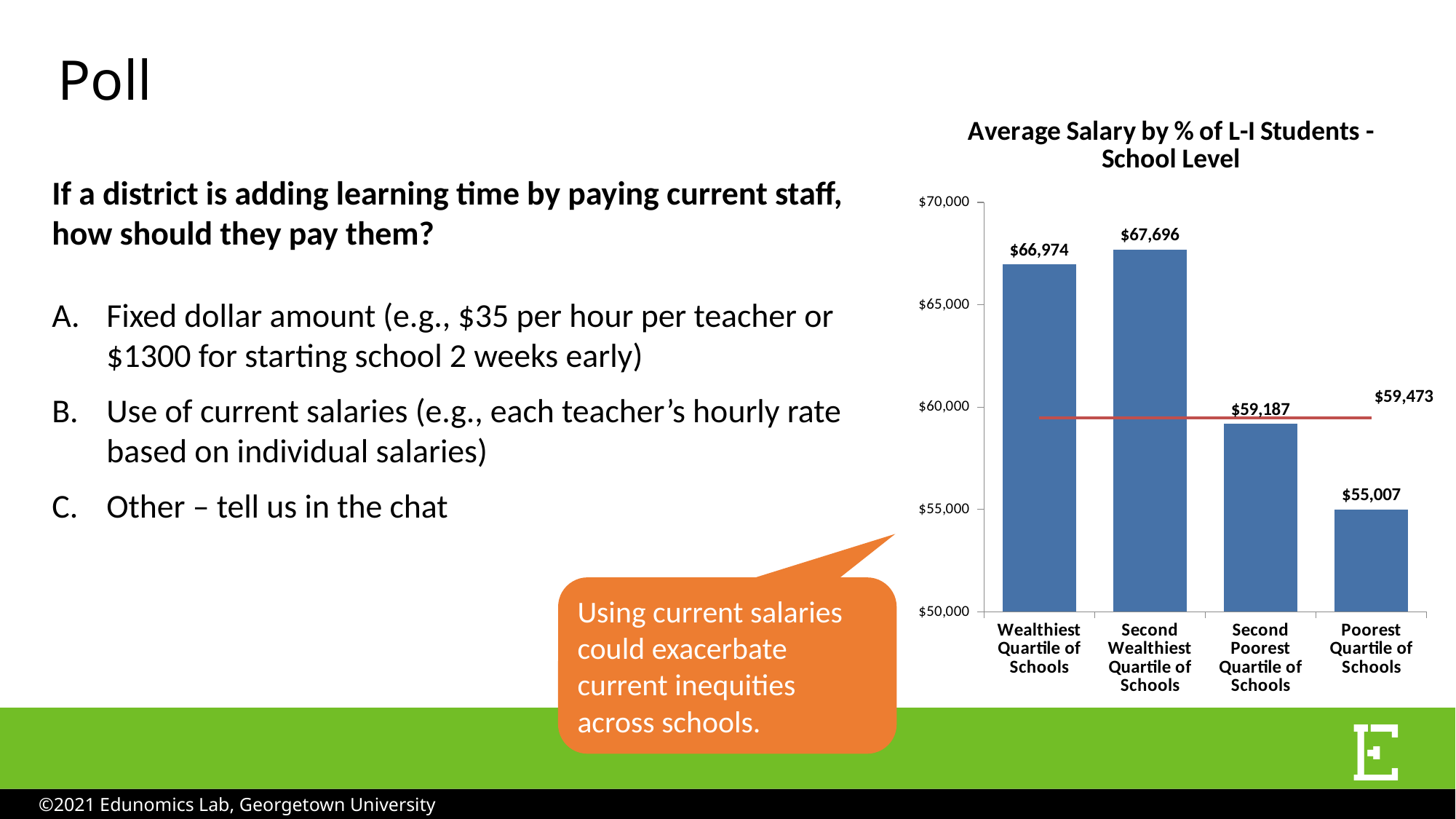
What is the average salary for the Second Poorest Quartile of Schools? $59,187 What is the difference in average salary between the Second Wealthiest Quartile of Schools and the Poorest Quartile of Schools? $12,689 What is the average salary for the Second Wealthiest Quartile of Schools? $67,696 What is the difference in average salary between the Wealthiest Quartile of Schools and the Second Poorest Quartile of Schools? $7,787 Which quartile of schools has the highest average salary? Second Wealthiest Quartile of Schools What is the average salary for the Wealthiest Quartile of Schools? $66,974 Which quartile of schools has the lowest average salary? Poorest Quartile of Schools Which has a higher average salary, the Wealthiest Quartile of Schools or the Second Poorest Quartile of Schools? Wealthiest Quartile of Schools What is the average salary for the Poorest Quartile of Schools? $55,007 How many quartile categories are shown on the chart? 4 What value is labelled on the horizontal red line across the chart? $59,473 What kind of chart is shown on the slide? Bar chart